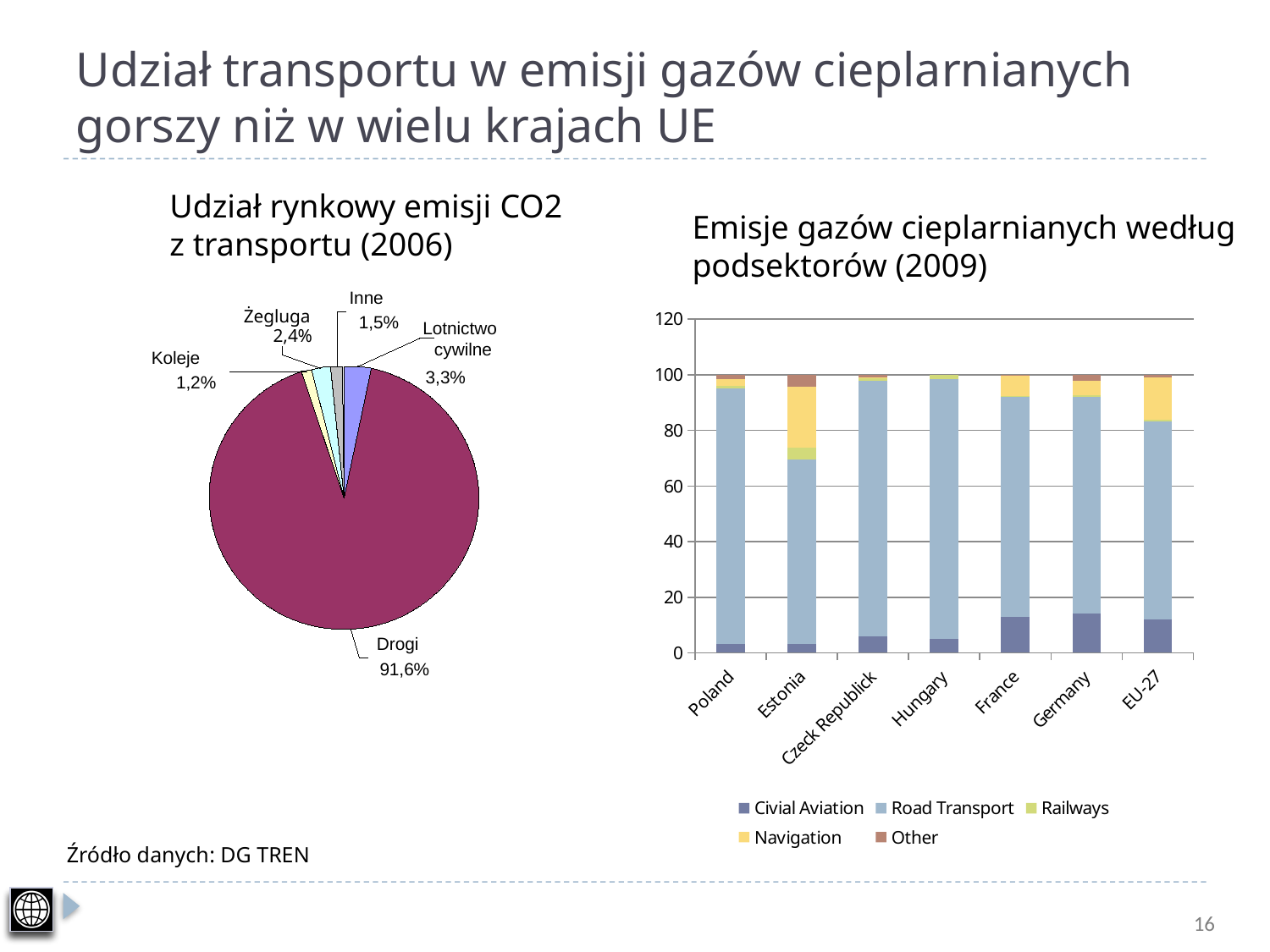
In the chart 'Emisje gazów cieplarnianych według podsektorów (2009)', is the Civil Aviation value for Germany greater or less than 20? less In the pie chart 'Udział rynkowy emisji CO2 z transportu (2006)', which category has the smallest share? Koleje What kind of chart is 'Emisje gazów cieplarnianych według podsektorów (2009)'? Stacked bar chart How many slices does the pie chart 'Udział rynkowy emisji CO2 z transportu (2006)' have? 5 In the chart 'Emisje gazów cieplarnianych według podsektorów (2009)', which country has the largest Navigation segment? Estonia In the pie chart 'Udział rynkowy emisji CO2 z transportu (2006)', what is the share for Żegluga? 2,4% How many countries/regions are shown on the x axis of the chart 'Emisje gazów cieplarnianych według podsektorów (2009)'? 7 In the pie chart 'Udział rynkowy emisji CO2 z transportu (2006)', what share does Drogi have? 91,6% In the pie chart 'Udział rynkowy emisji CO2 z transportu (2006)', what is the share for Lotnictwo cywilne? 3,3% How many series does the legend of the chart 'Emisje gazów cieplarnianych według podsektorów (2009)' list? 5 In the pie chart 'Udział rynkowy emisji CO2 z transportu (2006)', which is larger, Żegluga or Inne? Żegluga In the pie chart 'Udział rynkowy emisji CO2 z transportu (2006)', what is the difference in percentage points between Lotnictwo cywilne and Koleje? 2,1